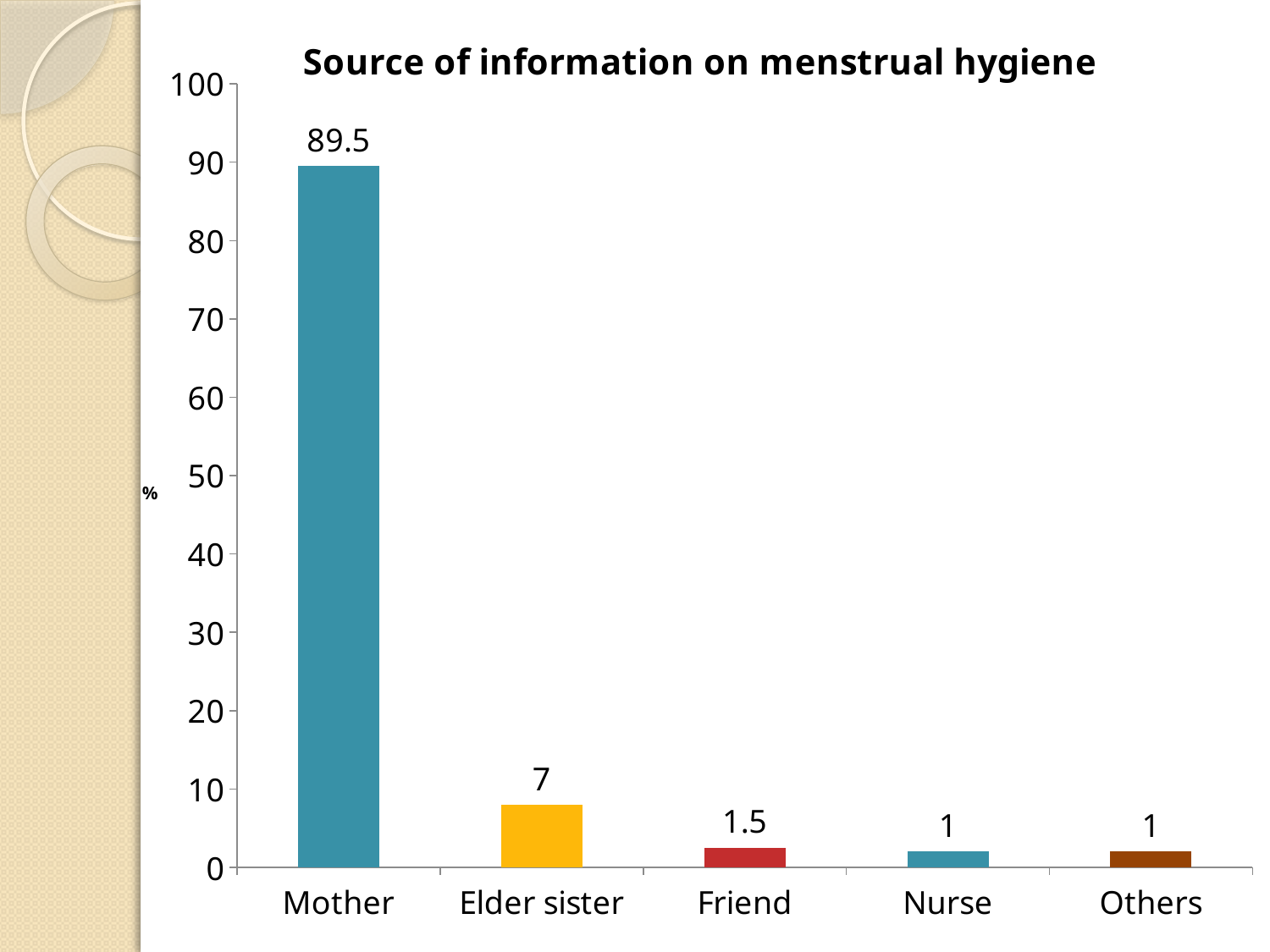
What is the difference between the values for Mother and Elder sister? 82.5 How many categories are shown on the x axis? 5 What is the value for Elder sister? 7 Which is larger, the value for Elder sister or the value for Friend? Elder sister What is the title of the chart? Source of information on menstrual hygiene Is the value for Mother greater or less than 80? greater What is the value for Nurse? 1 What kind of chart is shown on the slide? Bar chart Which category has the highest value? Mother What is the difference between the values for Elder sister and Friend? 5.5 What is the value for Mother? 89.5 What is the value for Friend? 1.5